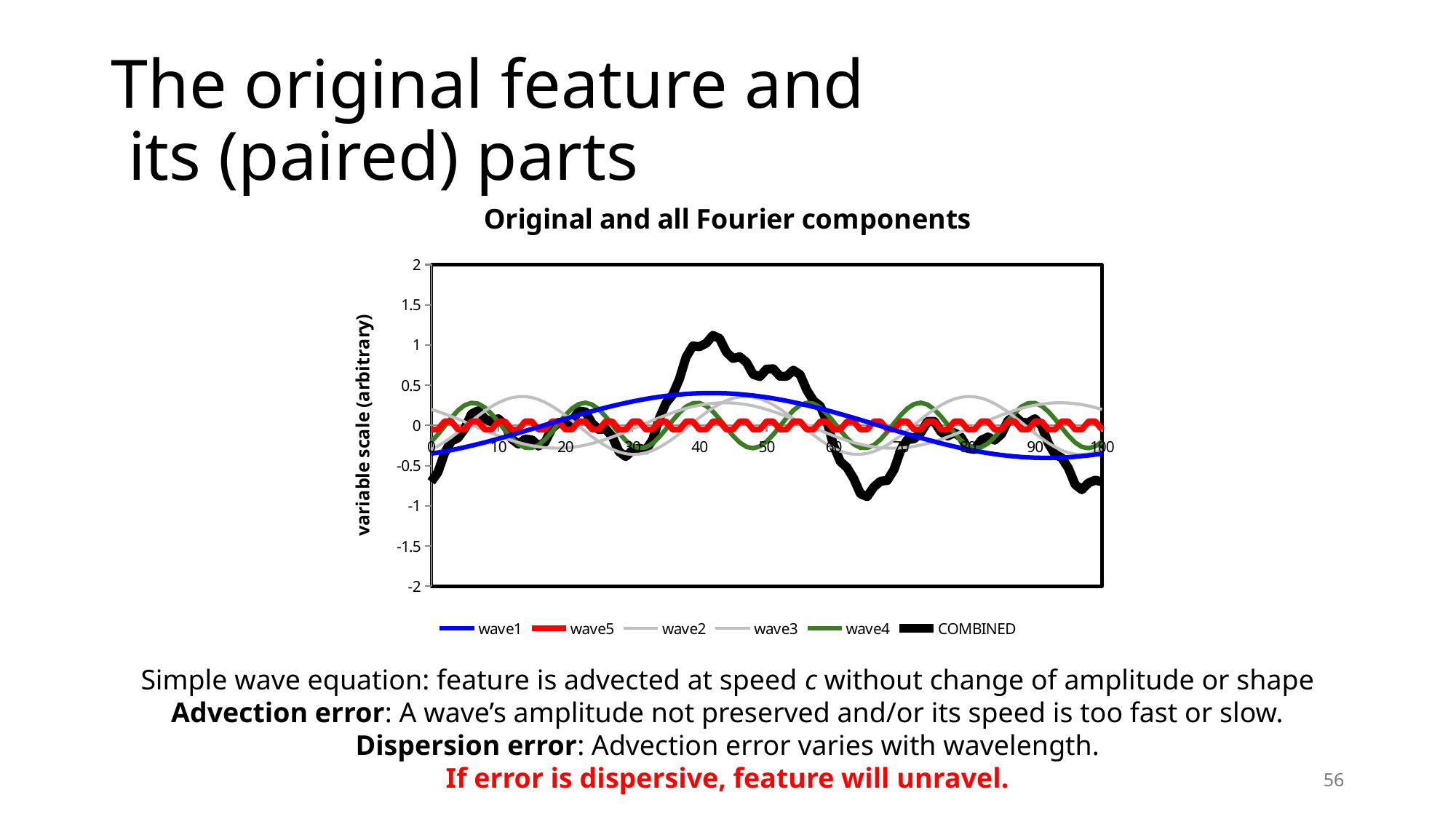
Is the lowest value of the COMBINED series near x = 65 greater or less than -0.5? less How many series does the legend list? 6 What is the highest value shown on the vertical axis? 2 Is the peak value of the COMBINED series near x = 40 greater or less than 0.5? greater Is the maximum value of wave1 greater or less than 0.5? less What kind of chart is shown on the slide? line chart Which series reaches the highest value on the chart? COMBINED Which series has the smallest amplitude on the chart? wave5 Which series reaches a larger peak value, wave1 or COMBINED? COMBINED What is the label on the vertical axis of the chart? variable scale (arbitrary) What is the title of the chart? Original and all Fourier components